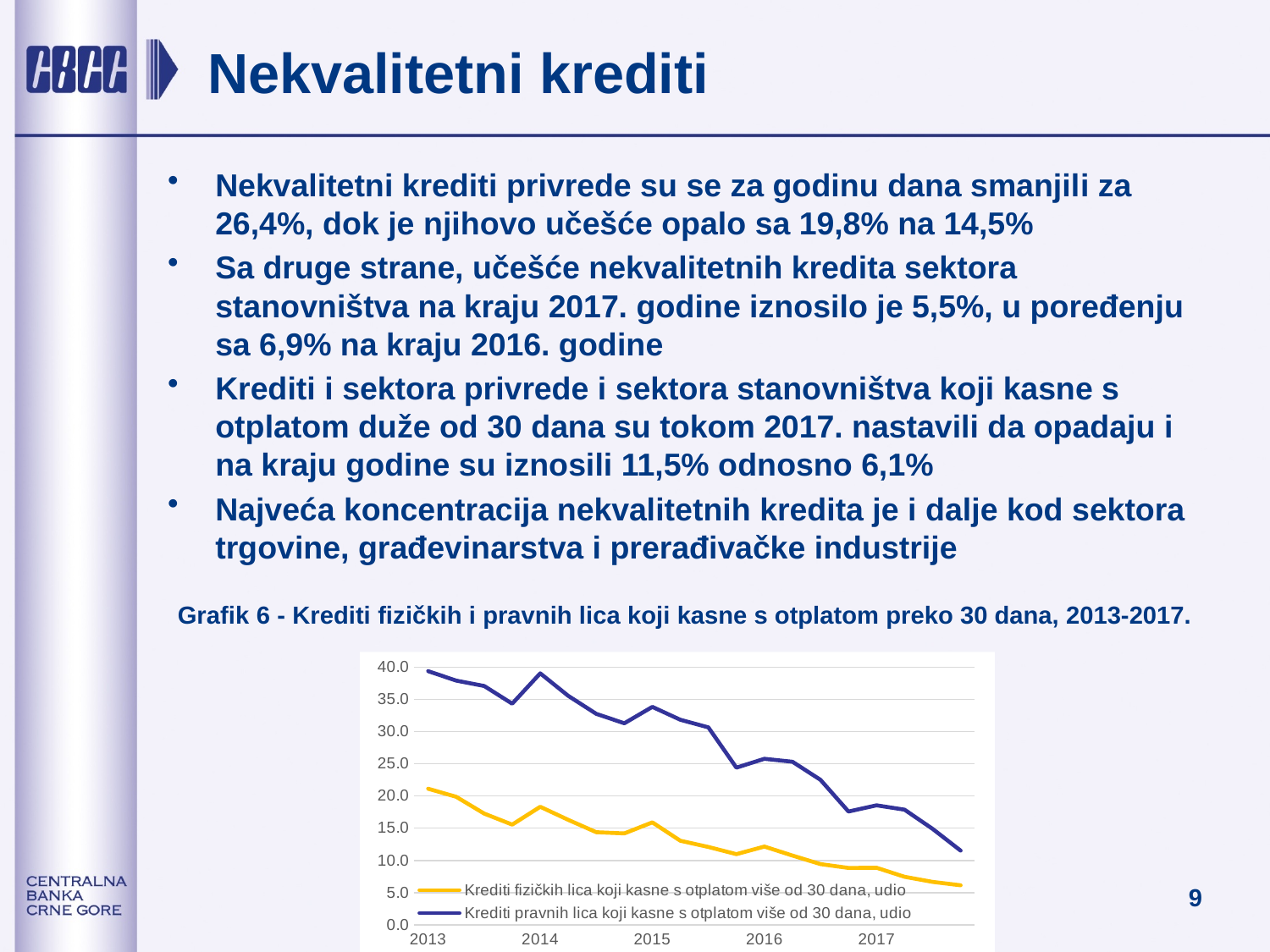
Is the value for 'Krediti fizičkih lica' at the start of 2014 greater or less than 20.0? less How many years are labelled on the x axis of the chart? 5 Is the value for 'Krediti pravnih lica' at the start of 2017 greater or less than 20.0? less At the start of 2016, which series has the higher value: 'Krediti pravnih lica' or 'Krediti fizičkih lica'? Krediti pravnih lica Is the value for 'Krediti pravnih lica' at the start of 2013 greater or less than 35.0? greater Does the line for 'Krediti fizičkih lica koji kasne s otplatom više od 30 dana, udio' rise or fall from 2013 to 2017? fall What is the title of the chart (Grafik 6)? Krediti fizičkih i pravnih lica koji kasne s otplatom preko 30 dana, 2013-2017. Which series is drawn in dark blue? Krediti pravnih lica koji kasne s otplatom više od 30 dana, udio What kind of chart is shown on the slide? line chart How many series does the chart legend list? 2 Does the line for 'Krediti pravnih lica koji kasne s otplatom više od 30 dana, udio' rise or fall from 2013 to 2017? fall